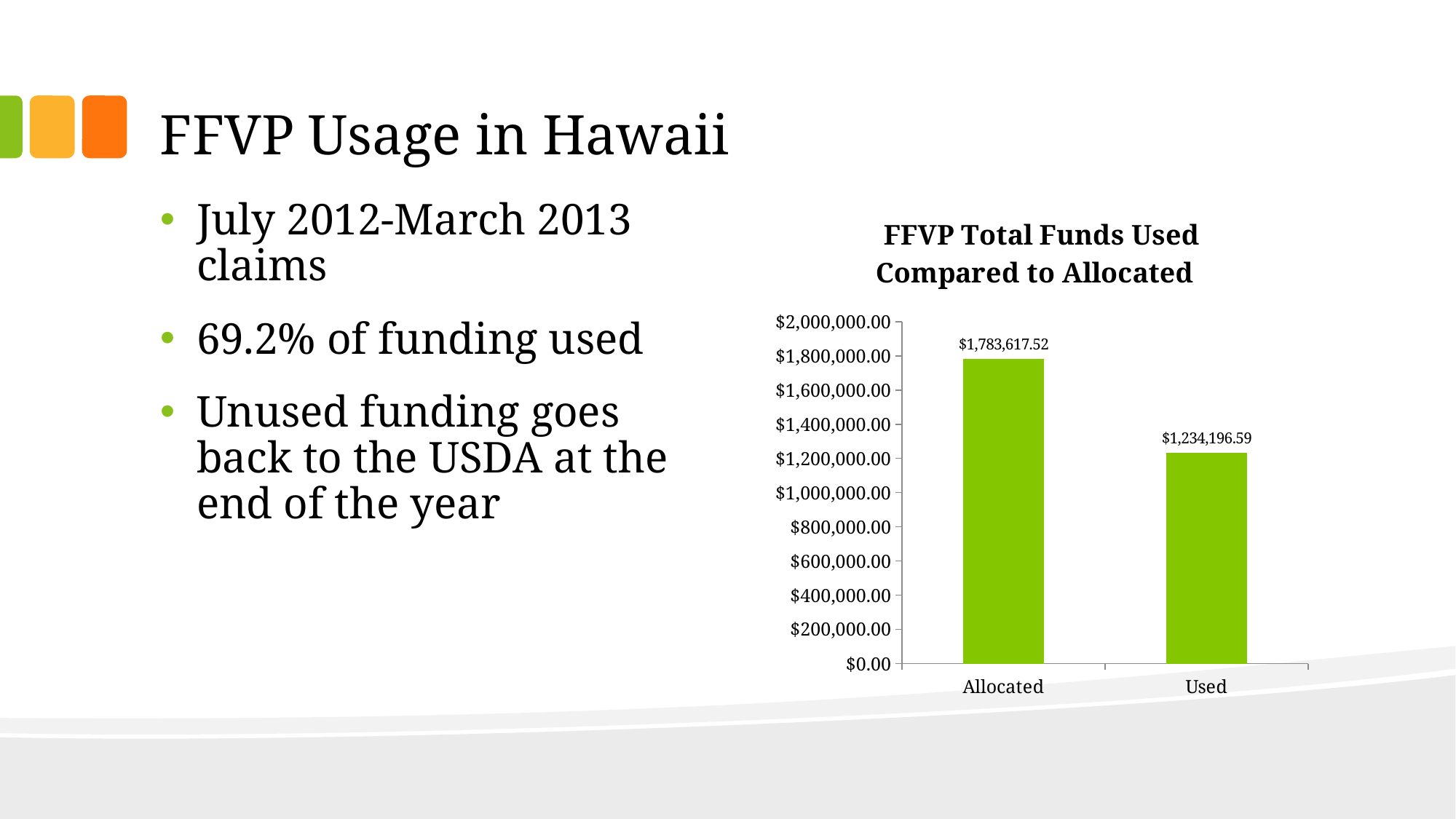
Is the value for Allocated greater or less than $1,600,000.00? greater What is the difference between the Allocated and Used values? $549,420.93 Which category has the highest value? Allocated Is the value for Used greater or less than $1,400,000.00? less What is the title of the chart? FFVP Total Funds Used Compared to Allocated How many categories are shown on the x axis of the chart? 2 What kind of chart is shown on the slide? Bar chart What is the value of the Used bar? $1,234,196.59 Which category has the lowest value? Used What colour are the bars in the chart? Green Which category has the higher value, Allocated or Used? Allocated What is the value of the Allocated bar? $1,783,617.52